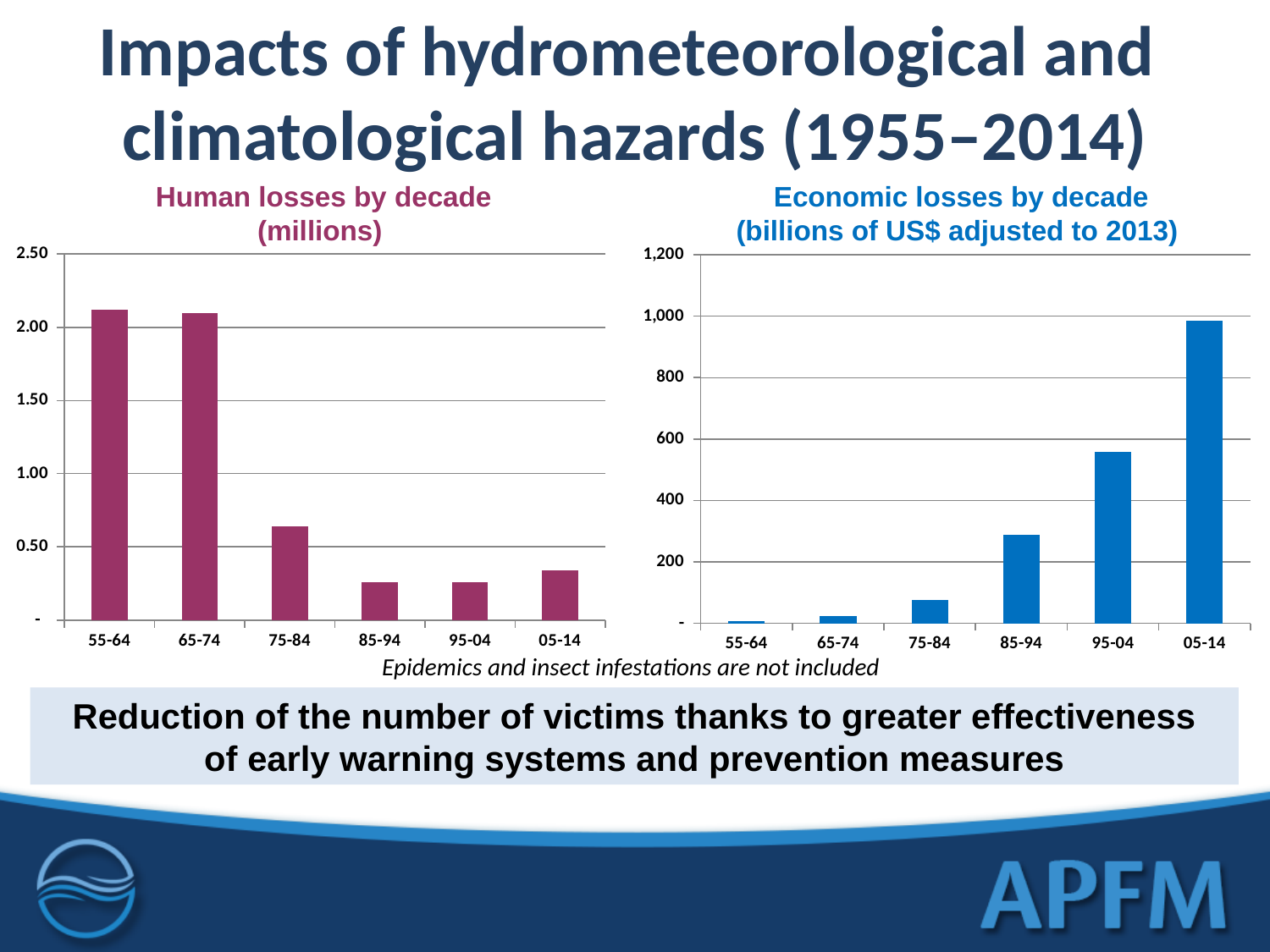
In the 'Economic losses by decade' chart, which decade has the highest value? 05-14 What kind of chart is the 'Human losses by decade (millions)' chart? bar chart How many decades are shown on the x axis of the 'Economic losses by decade' chart? 6 In the 'Economic losses by decade' chart, do the values rise or fall from 55-64 to 05-14? rise In the 'Economic losses by decade' chart, is the value for 75-84 greater or less than 200? less In the 'Economic losses by decade' chart, which decade has the lowest value? 55-64 In the 'Economic losses by decade' chart, is the value for 95-04 greater or less than 400? greater What colour are the bars in the 'Economic losses by decade' chart? blue In the 'Human losses by decade (millions)' chart, which is larger, the value for 75-84 or the value for 05-14? 75-84 In the 'Human losses by decade (millions)' chart, is the value for 55-64 greater or less than 2.00? greater